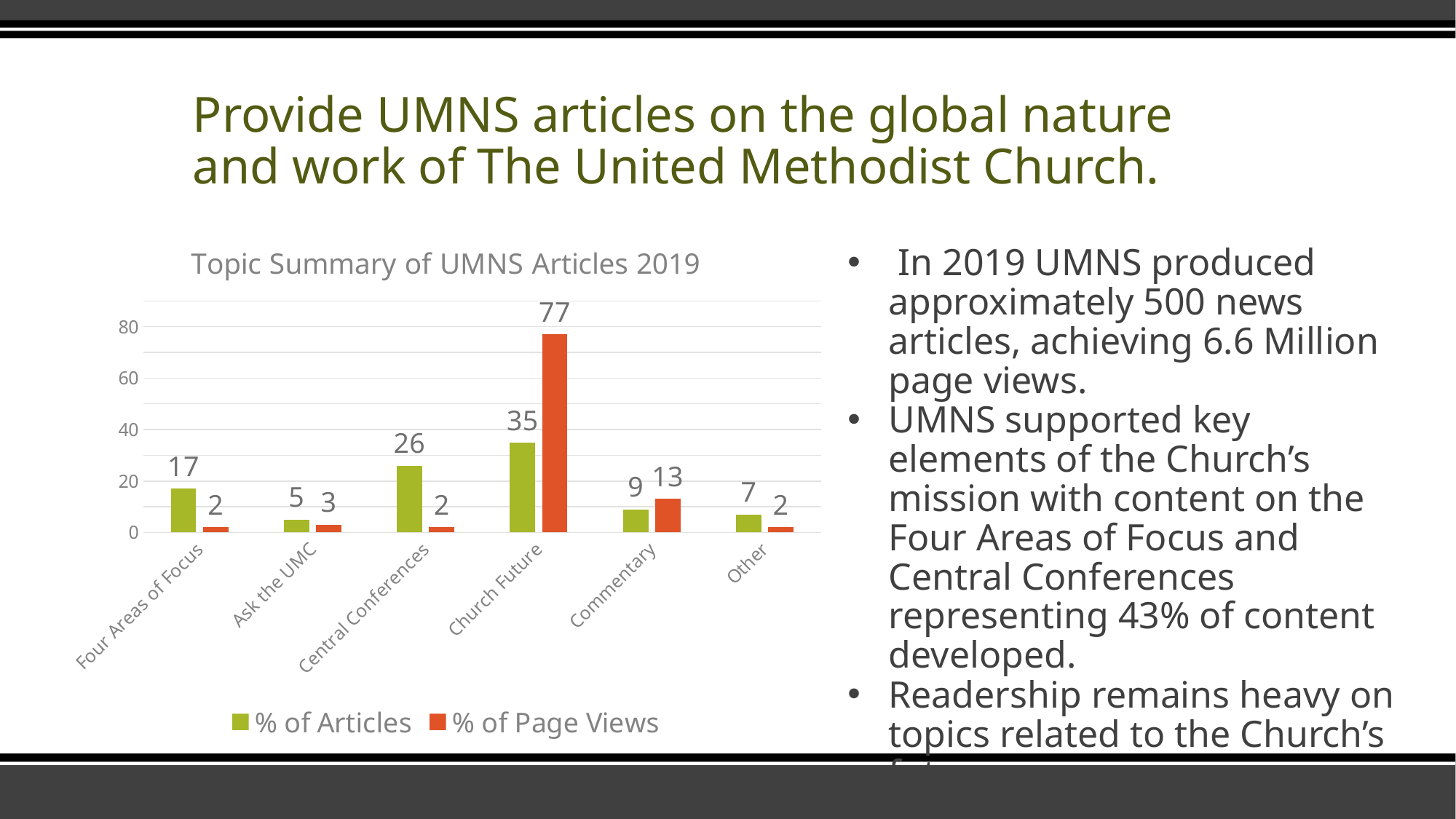
Which category has the lowest % of Articles? Ask the UMC What is the % of Articles value for Church Future? 35 What is the difference between % of Page Views and % of Articles for Church Future? 42 What is the % of Page Views value for Central Conferences? 2 What is the % of Articles value for Four Areas of Focus? 17 What is the title of the chart? Topic Summary of UMNS Articles 2019 What kind of chart is shown? Bar chart Which category has the highest % of Page Views? Church Future Which is larger for Commentary: % of Articles or % of Page Views? % of Page Views What colour represents % of Page Views in the legend? Orange How many series does the legend list? 2 How many categories are shown on the x axis? 6